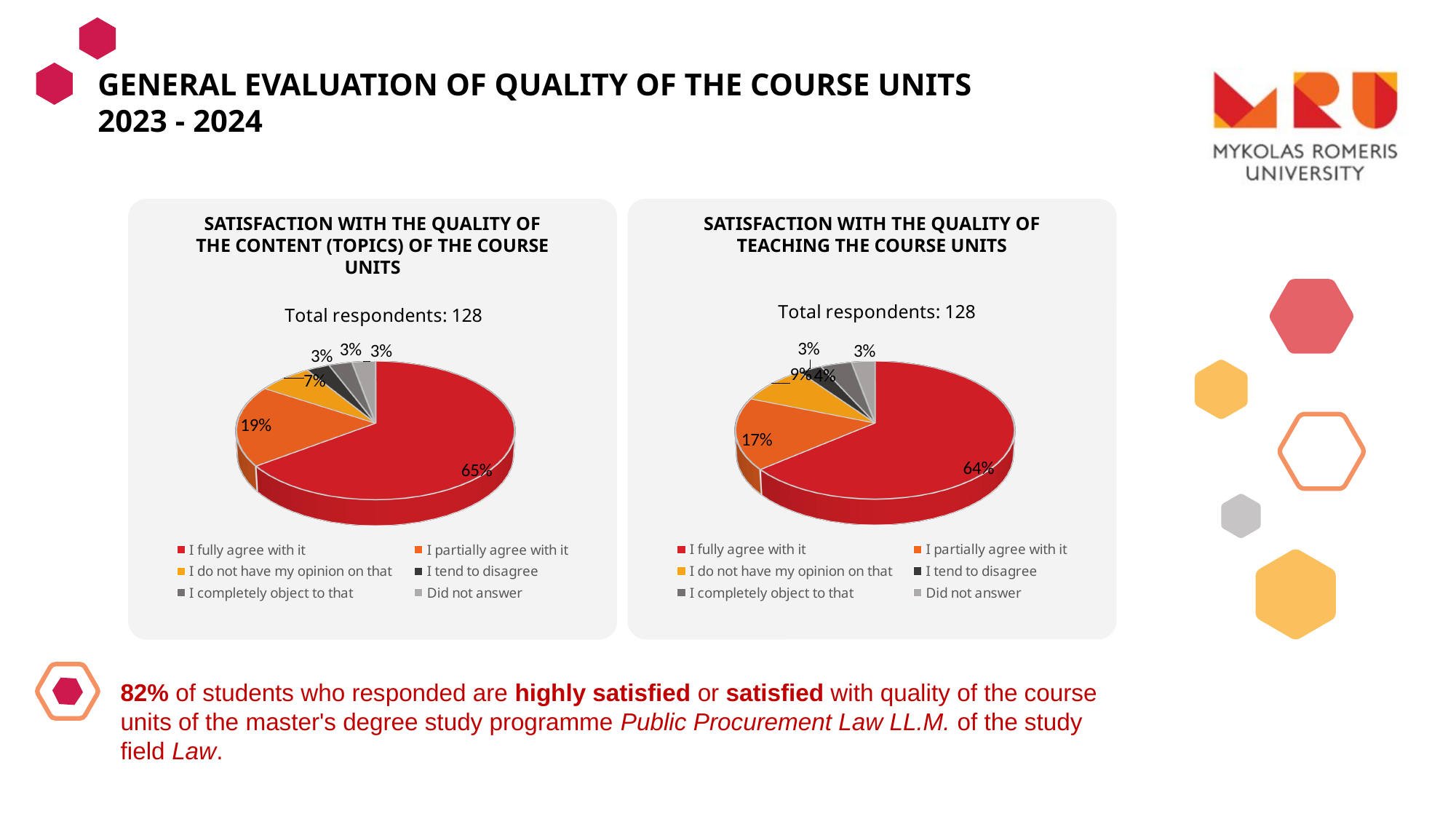
In the right chart (teaching the course units), what percentage of respondents partially agree with it? 17% In the right chart (teaching the course units), what is the combined share of respondents who fully agree or partially agree? 81% In the chart titled 'Satisfaction with the quality of the content (topics) of the course units', what share of respondents fully agree with it? 65% In the left chart (content of the course units), what percentage of respondents partially agree with it? 19% How many response categories does the legend of the left chart (content of the course units) list? 6 In the left chart (content of the course units), which response category has the largest share? I fully agree with it How many total respondents are reported for the chart titled 'Satisfaction with the quality of teaching the course units'? 128 In the left chart (content of the course units), what is the difference between the 'I fully agree with it' and 'I partially agree with it' shares? 46% In the right chart (teaching the course units), what percentage of respondents do not have an opinion on that? 9% Which is larger: the 'I partially agree with it' share in the left chart (content) or in the right chart (teaching)? Left chart (content), 19% What type of chart is used for 'Satisfaction with the quality of teaching the course units'? Pie chart In the chart titled 'Satisfaction with the quality of teaching the course units', what share of respondents fully agree with it? 64%